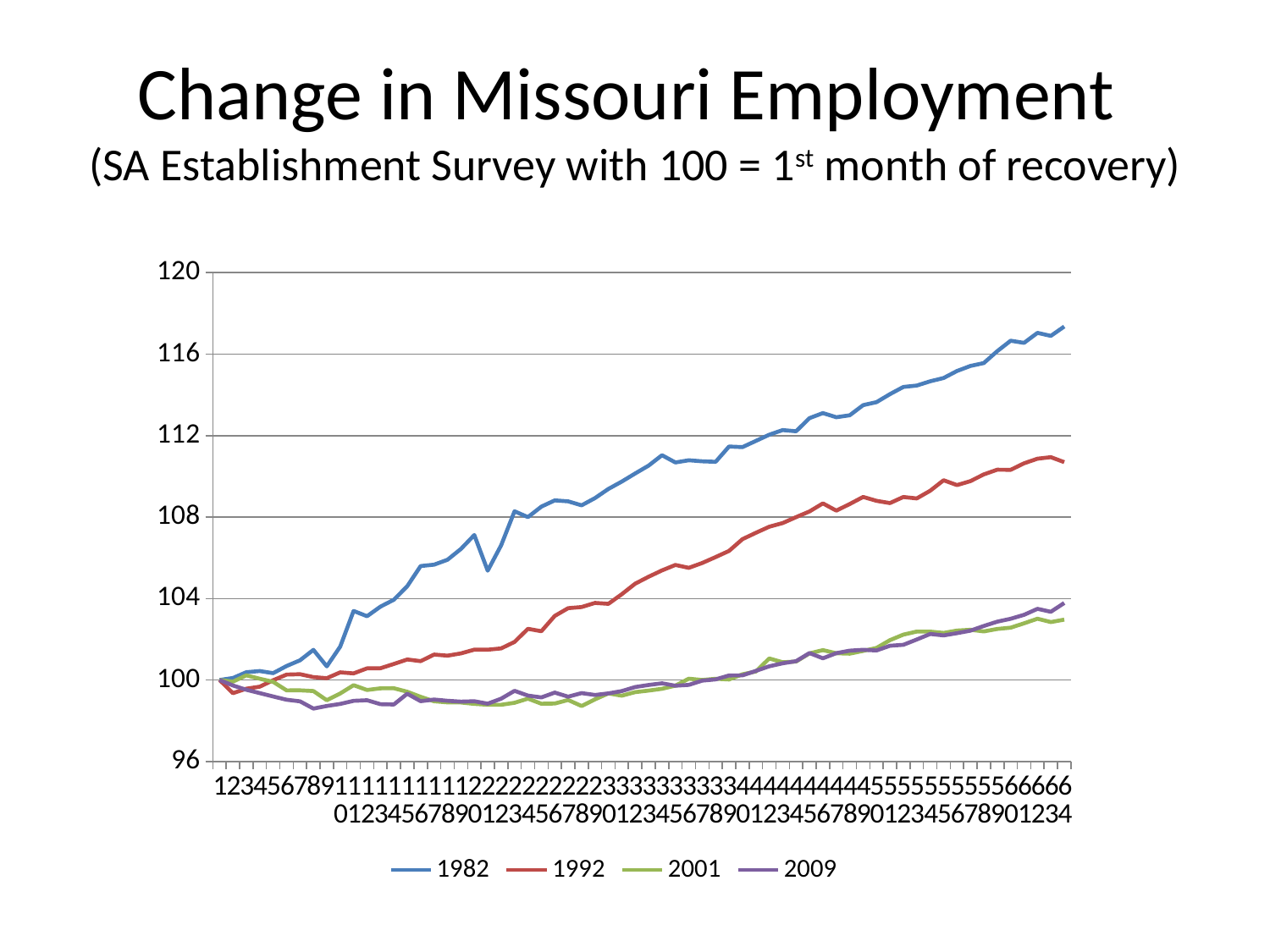
Which series has the highest value at the last month shown (month 64)? 1982 Is the value for the 2001 series at month 64 greater or less than 104? less Is the value for the 1982 series at month 64 greater or less than 116? greater What kind of chart is shown on the slide? line chart How many months are plotted along the x axis? 64 Does the 1982 series generally rise or fall as the months increase? rise How many series does the legend list? 4 Which series does the legend list first? 1982 What is the value of every series in the 1st month of recovery? 100 Is the value for the 1992 series at month 64 greater or less than 112? less What is the title of the chart on the slide? Change in Missouri Employment At month 40, which series has the larger value, 1982 or 1992? 1982